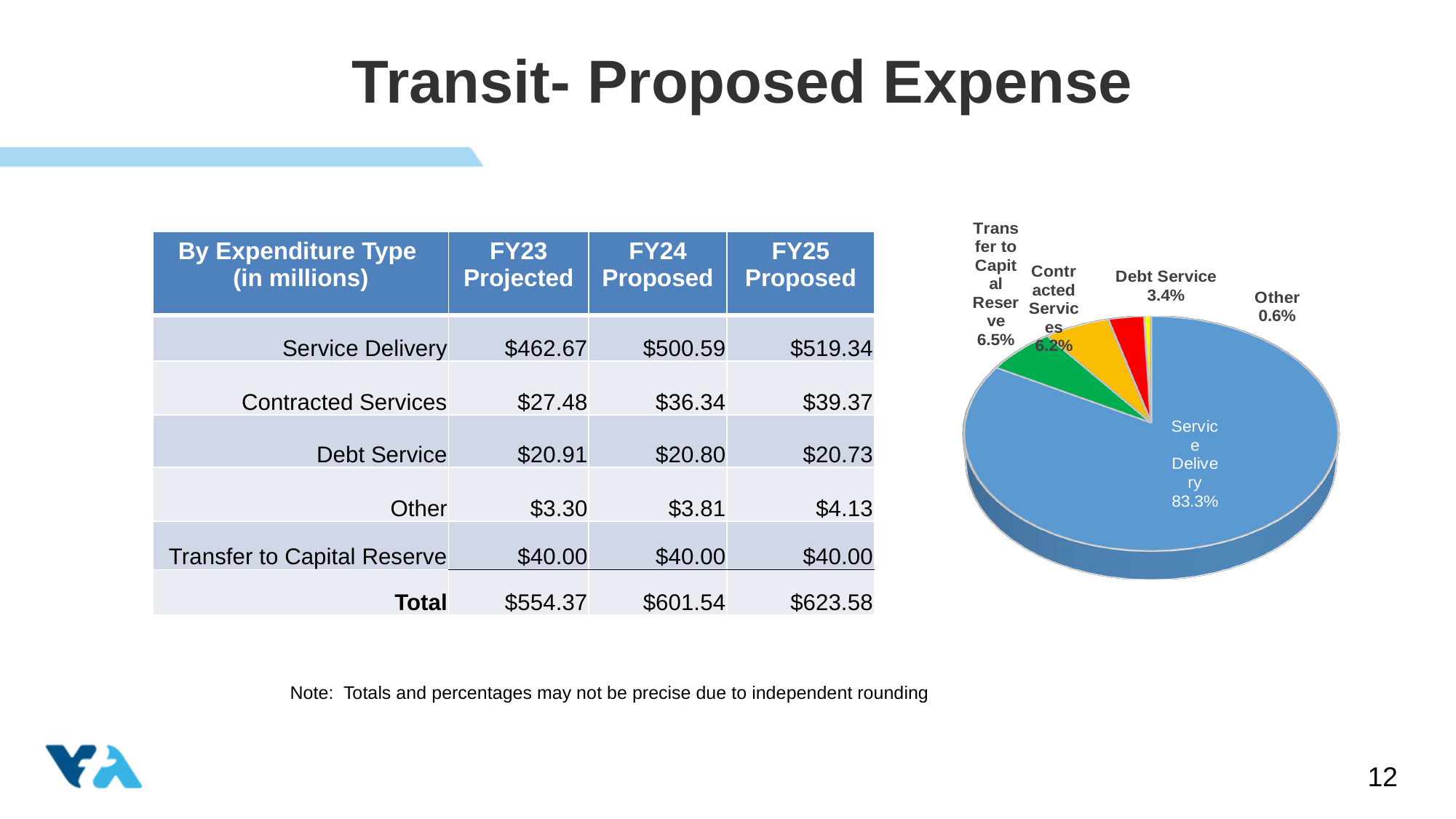
What share of the pie chart does Other represent? 0.6% What share of the pie chart does Debt Service represent? 3.4% In the pie chart, what is the difference in percentage points between Service Delivery and Transfer to Capital Reserve? 76.8 How many slices does the pie chart have? 5 What kind of chart is shown on the right side of the slide? pie chart In the pie chart, which is larger: Debt Service or Contracted Services? Contracted Services Which slice of the pie chart is the largest? Service Delivery What share of the pie chart does Transfer to Capital Reserve represent? 6.5% What colour is the Service Delivery slice in the pie chart? blue Which slice of the pie chart is the smallest? Other